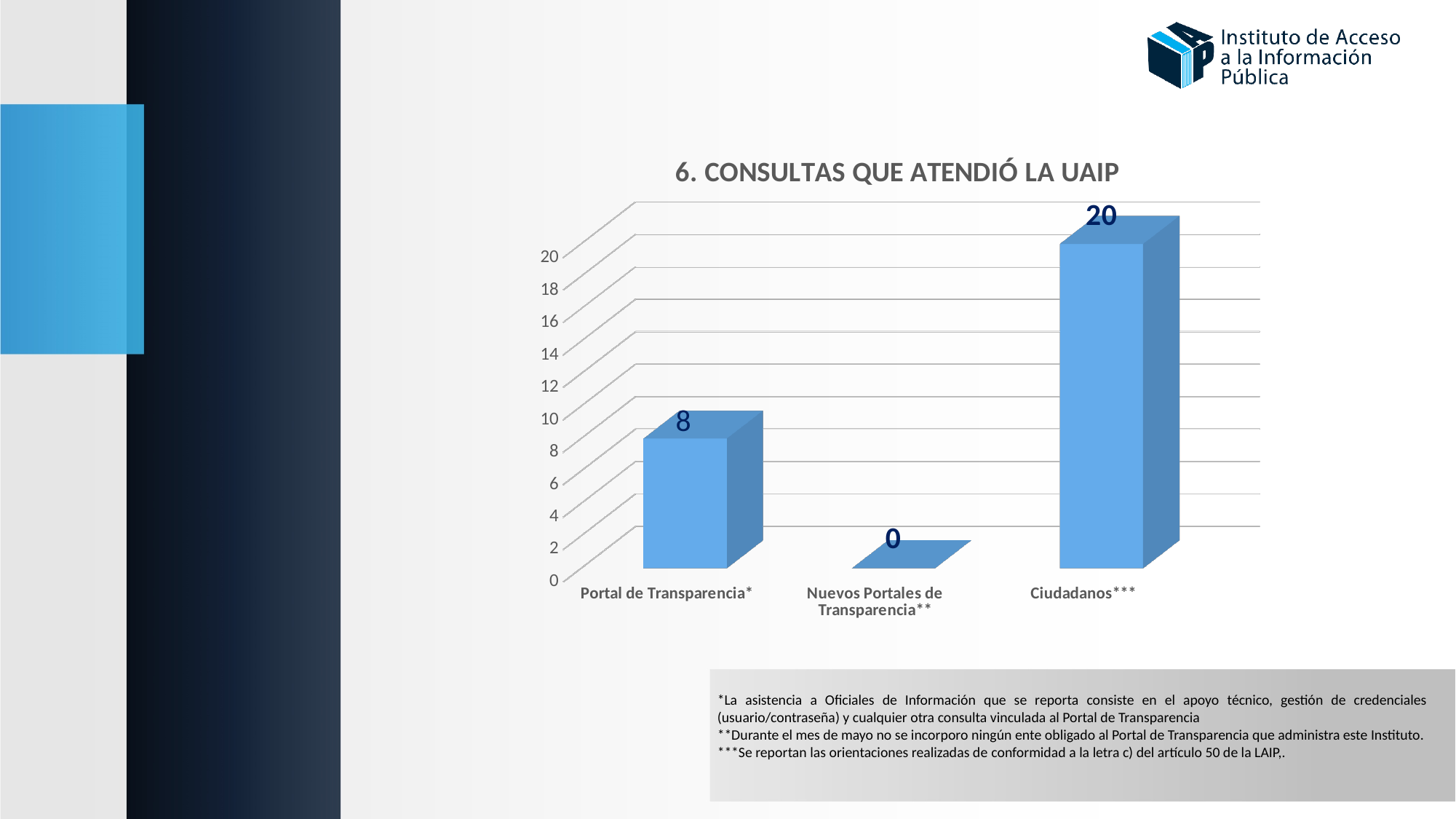
What is the highest value shown on the vertical axis? 20 What kind of chart is shown on the slide? bar chart What is the value for Nuevos Portales de Transparencia**? 0 Which category has the lowest value? Nuevos Portales de Transparencia** What is the value for Portal de Transparencia*? 8 How many categories are shown on the chart? 3 Which is larger, the value for Portal de Transparencia* or the value for Ciudadanos***? Ciudadanos*** Is the value for Portal de Transparencia* greater or less than 10? less What is the value for Ciudadanos***? 20 What is the title of the chart? 6. CONSULTAS QUE ATENDIÓ LA UAIP What is the difference between the values for Ciudadanos*** and Portal de Transparencia*? 12 Which category has the highest value? Ciudadanos***